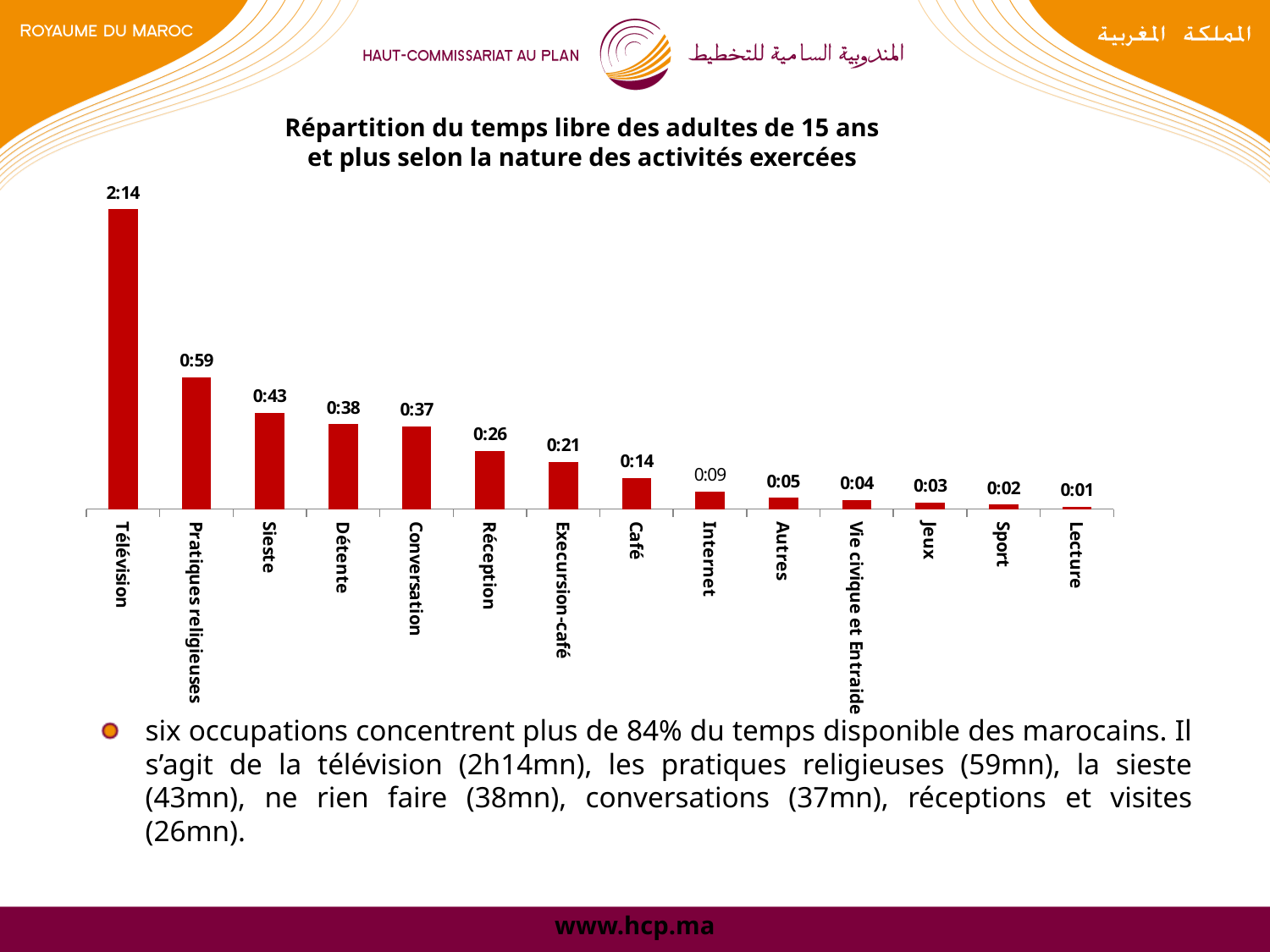
Which is larger, the value for Réception or the value for Café? Réception What is the value shown for Sieste? 0:43 Which category has the highest value? Télévision What is the value shown for Internet? 0:09 Do the values rise or fall from left to right along the x axis? Fall What is the value shown for Vie civique et Entraide? 0:04 What is the value shown for Pratiques religieuses? 0:59 What is the value shown for Télévision? 2:14 What kind of chart is shown on the slide? Bar chart How many categories are shown on the x axis? 14 What is the difference between the values for Sieste and Détente? 0:05 Which category has the lowest value? Lecture